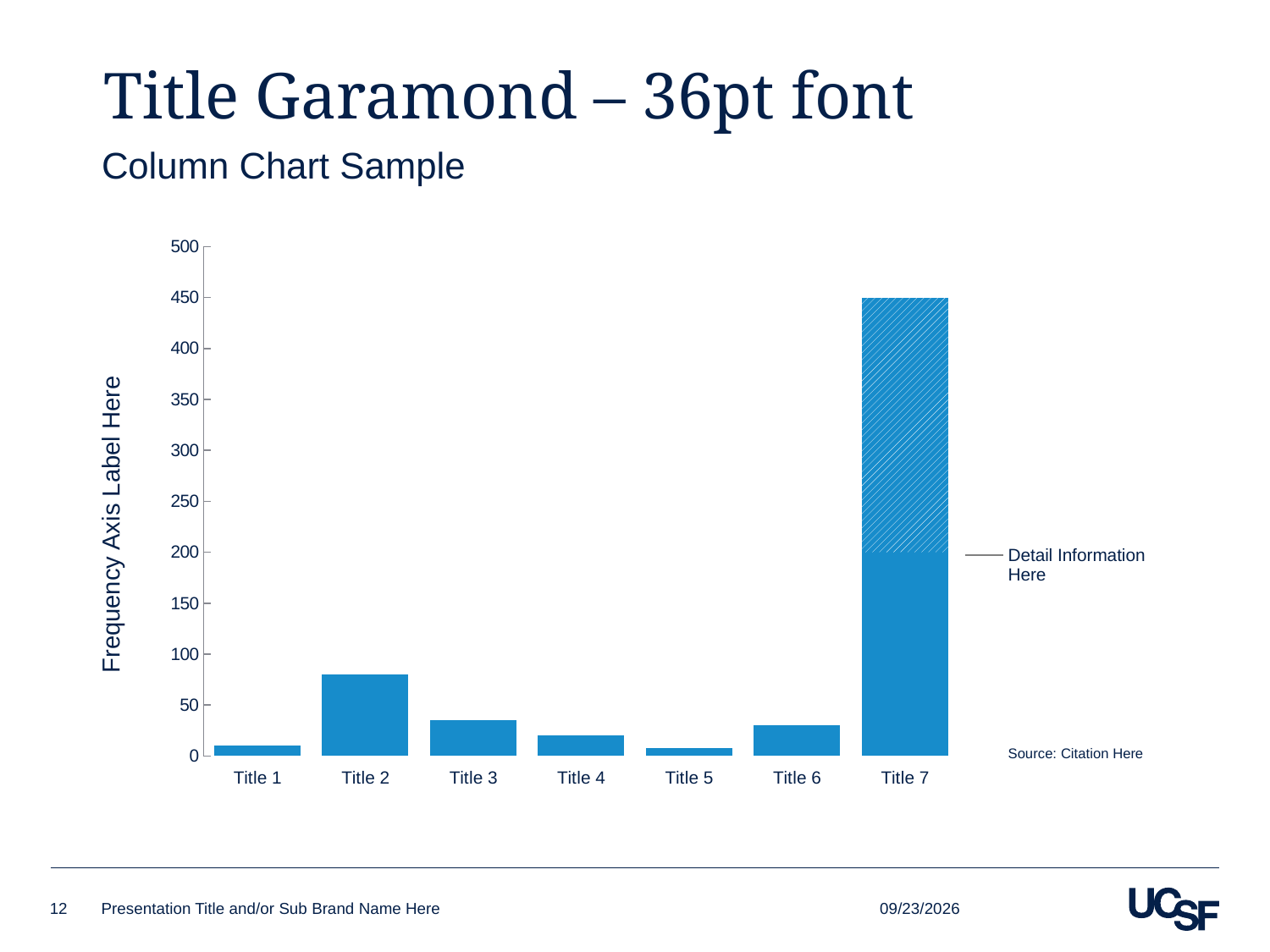
Is the value for Title 2 greater or less than 100? less Is the value for Title 7 greater or less than 400? greater Is the value for Title 2 greater or less than 50? greater What is the label on the vertical axis of the chart? Frequency Axis Label Here What kind of chart is shown on the slide? bar chart Which is larger, the value for Title 2 or the value for Title 3? Title 2 Which category has the highest value in the chart? Title 7 How many categories are plotted on the x axis of the chart? 7 Which is larger, the value for Title 6 or the value for Title 7? Title 7 What text does the annotation pointing to the Title 7 bar say? Detail Information Here